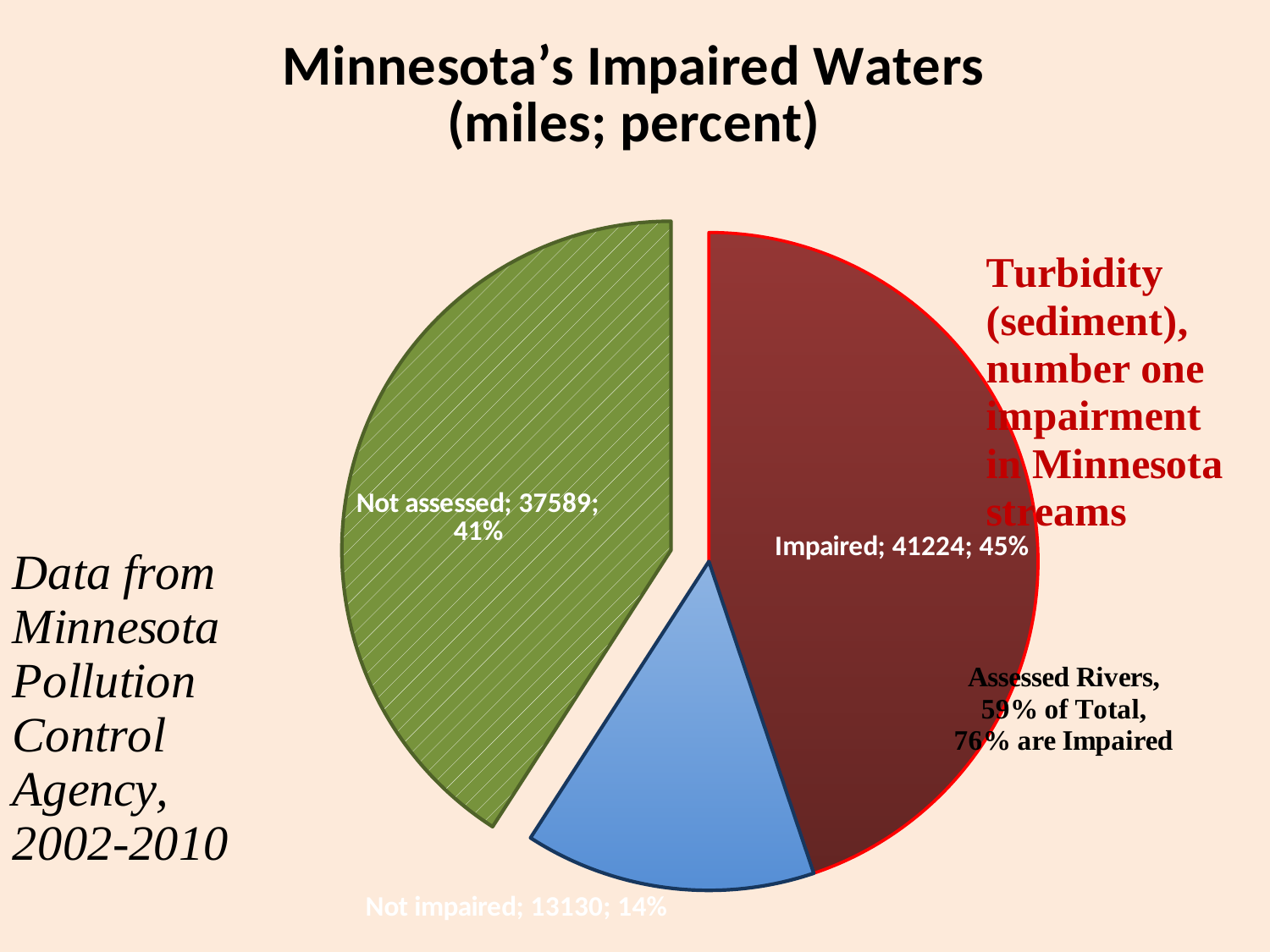
How many slices does the pie chart have? 3 What is the title of the chart? Minnesota's Impaired Waters (miles; percent) Which slice of the pie chart is the smallest? Not impaired Which has more miles, Not assessed or Not impaired? Not assessed How many miles are shown for the Not assessed slice? 37589 Which slice of the pie chart is the largest? Impaired What percentage of the pie does the Not impaired slice represent? 14% How many miles are shown for the Not impaired slice? 13130 What is the difference in miles between the Impaired and Not impaired slices? 28094 How many miles are shown for the Impaired slice? 41224 What percentage of the pie does the Impaired slice represent? 45% What type of chart is shown on the slide? pie chart